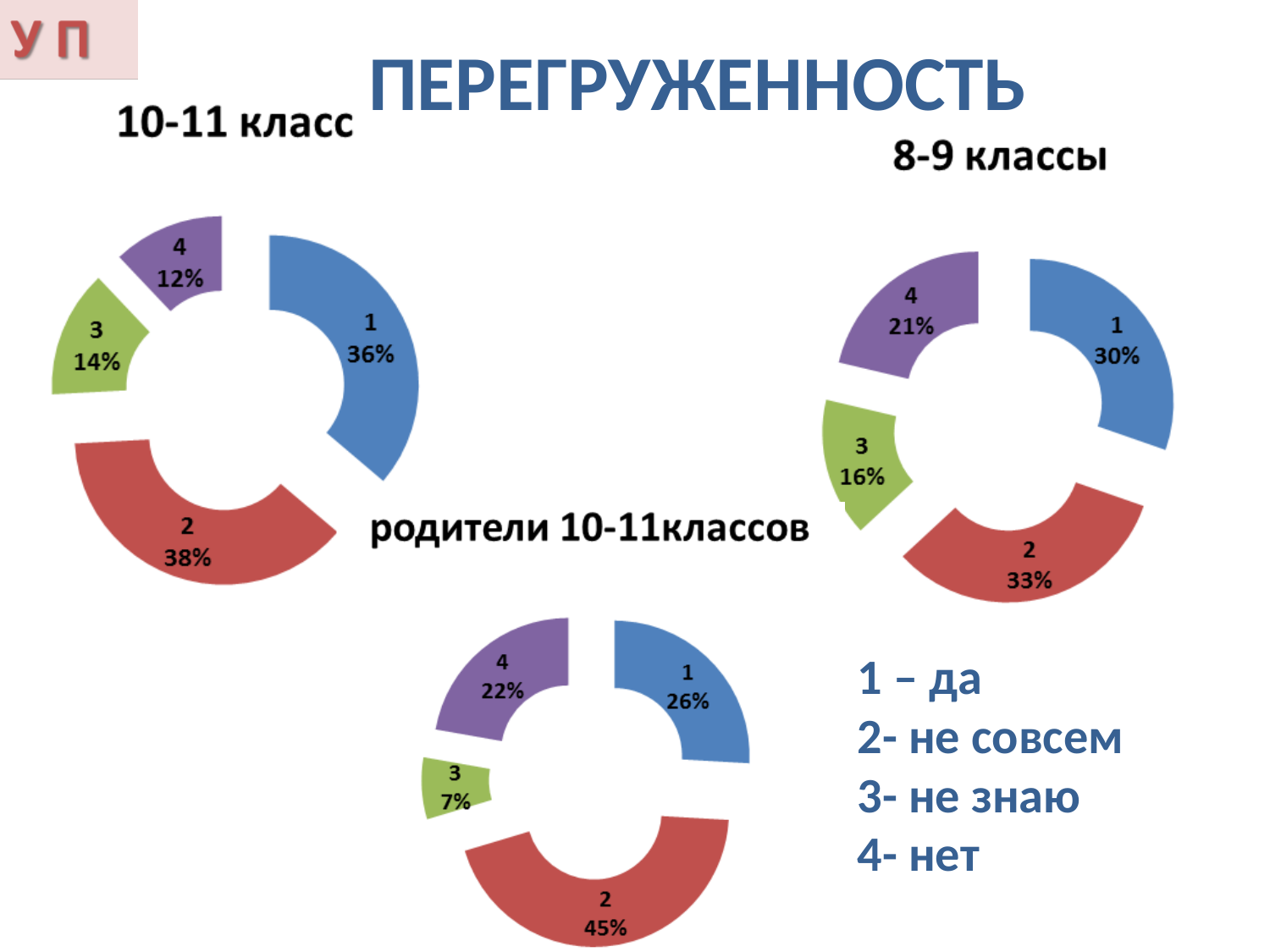
In the "родители 10-11классов" chart, which category has the largest share? 2 In the "8-9 классы" chart, which category has the smallest share? 3 How many charts are on the slide? 3 In the "родители 10-11классов" chart, what is the value for category 3? 7% How many categories does the "10-11 класс" chart show? 4 What kind of chart is the "8-9 классы" chart? doughnut chart What is the title of the slide? ПЕРЕГРУЖЕННОСТЬ In the "8-9 классы" chart, what is the value for category 4? 21% In the "родители 10-11классов" chart, what is the difference between category 2 and category 1? 19% In the "8-9 классы" chart, which is larger: category 4 or category 3? 4 In the "10-11 класс" chart, what is the value for category 2? 38% In the "10-11 класс" chart, which category has the smallest share? 4